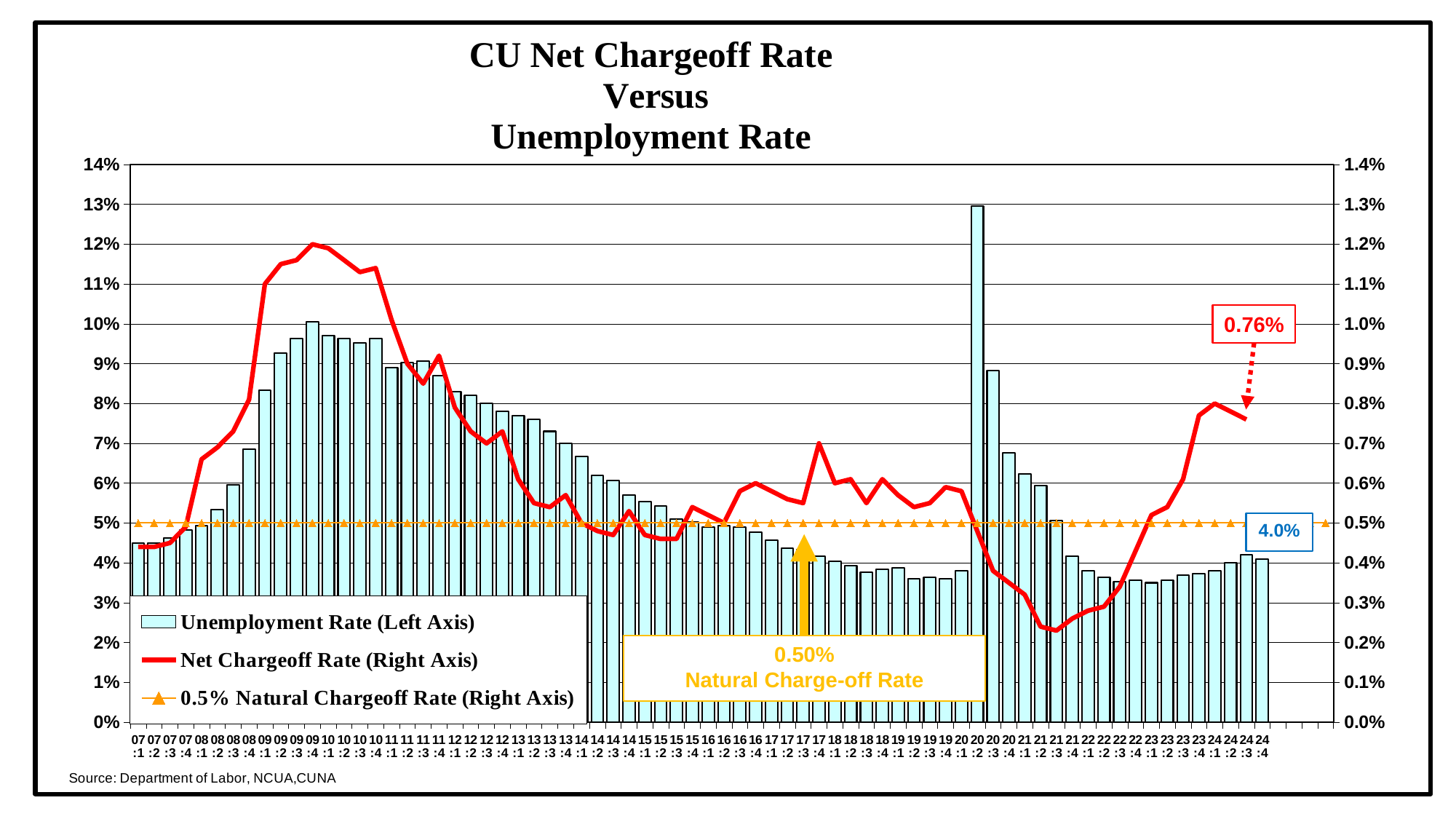
Is the Net Chargeoff Rate for 09:4 greater or less than 1.1%? greater What is the title of the chart? CU Net Chargeoff Rate Versus Unemployment Rate What is the Unemployment Rate labelled for the last quarter (24:4)? 4.0% Is the Net Chargeoff Rate for 21:3 greater or less than 0.3%? less How many series does the legend list? 3 What kind of chart is this? Combination bar and line chart What value is labelled as the Natural Charge-off Rate? 0.50% By how much does the Net Chargeoff Rate at 24:4 (0.76%) exceed the 0.50% Natural Charge-off Rate? 0.26% What is the Net Chargeoff Rate labelled for the last quarter (24:4)? 0.76% Is the Unemployment Rate for 20:2 greater or less than 12%? greater Which quarter has the highest Unemployment Rate? 20:2 Which is larger at 24:4: the Net Chargeoff Rate or the 0.5% Natural Chargeoff Rate? Net Chargeoff Rate